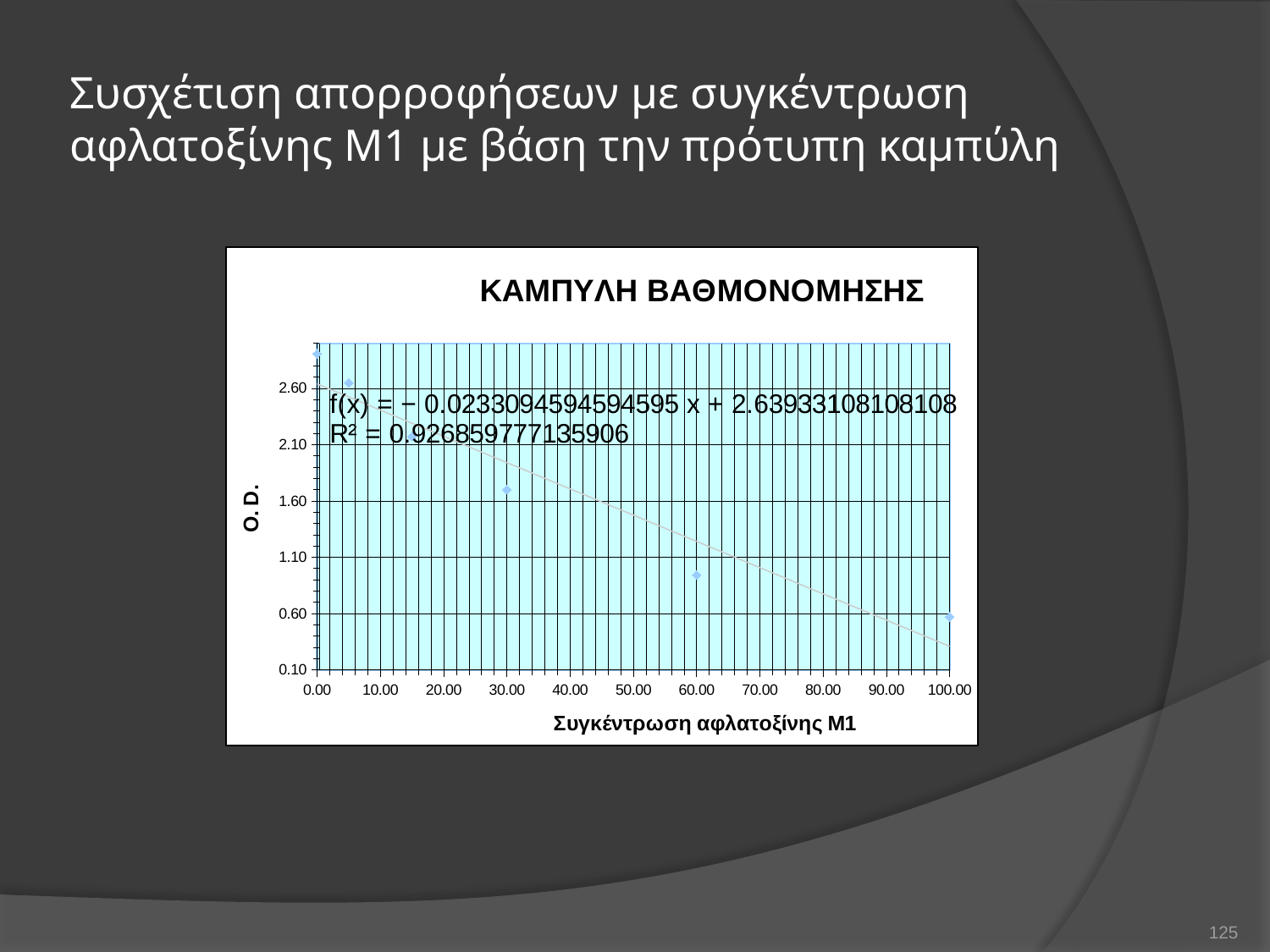
Is the O.D. value at concentration 60.00 greater or less than 1.60? less Is the O.D. value at concentration 100.00 greater or less than 1.10? less Which has the larger O.D. value: the point at concentration 30.00 or the point at concentration 60.00? 30.00 Is the O.D. value at concentration 30.00 greater or less than 1.10? greater What R² value is displayed on the chart for the trendline? 0.926859777135906 What is the title of the chart? ΚΑΜΠΥΛΗ ΒΑΘΜΟΝΟΜΗΣΗΣ How many data points are plotted in the chart? 6 At which x-axis concentration is the O.D. value lowest? 100.00 At which x-axis concentration is the O.D. value highest? 0.00 Do the O.D. values rise or fall as the aflatoxin M1 concentration increases along the x axis? fall What kind of chart is shown on the slide? scatter chart